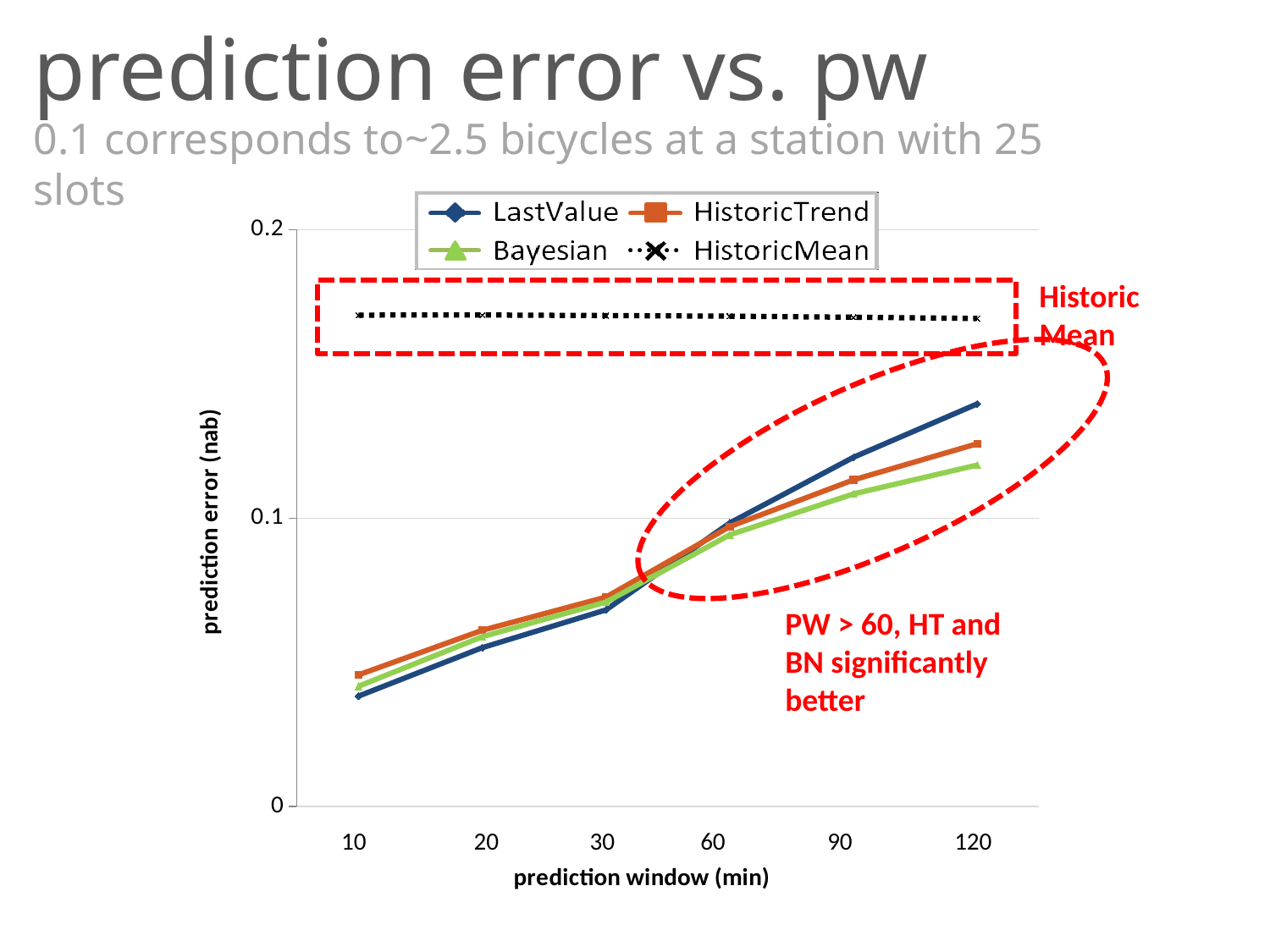
Does the HistoricMean line rise, fall, or stay roughly flat across the prediction windows? stay roughly flat Which series has the lowest prediction error at a prediction window of 120? Bayesian Is the prediction error for HistoricMean at a prediction window of 120 greater or less than 0.1? greater How many prediction window values are plotted along the x axis? 6 How many series does the legend list? 4 Is the prediction error for HistoricMean at a prediction window of 10 greater or less than 0.2? less What kind of chart is shown on the slide? line chart At a prediction window of 120, which has the larger prediction error, LastValue or Bayesian? LastValue Which series has the highest prediction error at a prediction window of 120? HistoricMean Is the prediction error for LastValue at a prediction window of 10 greater or less than 0.1? less What is the title of the x axis? prediction window (min) Does the prediction error for LastValue rise or fall as the prediction window increases? rise